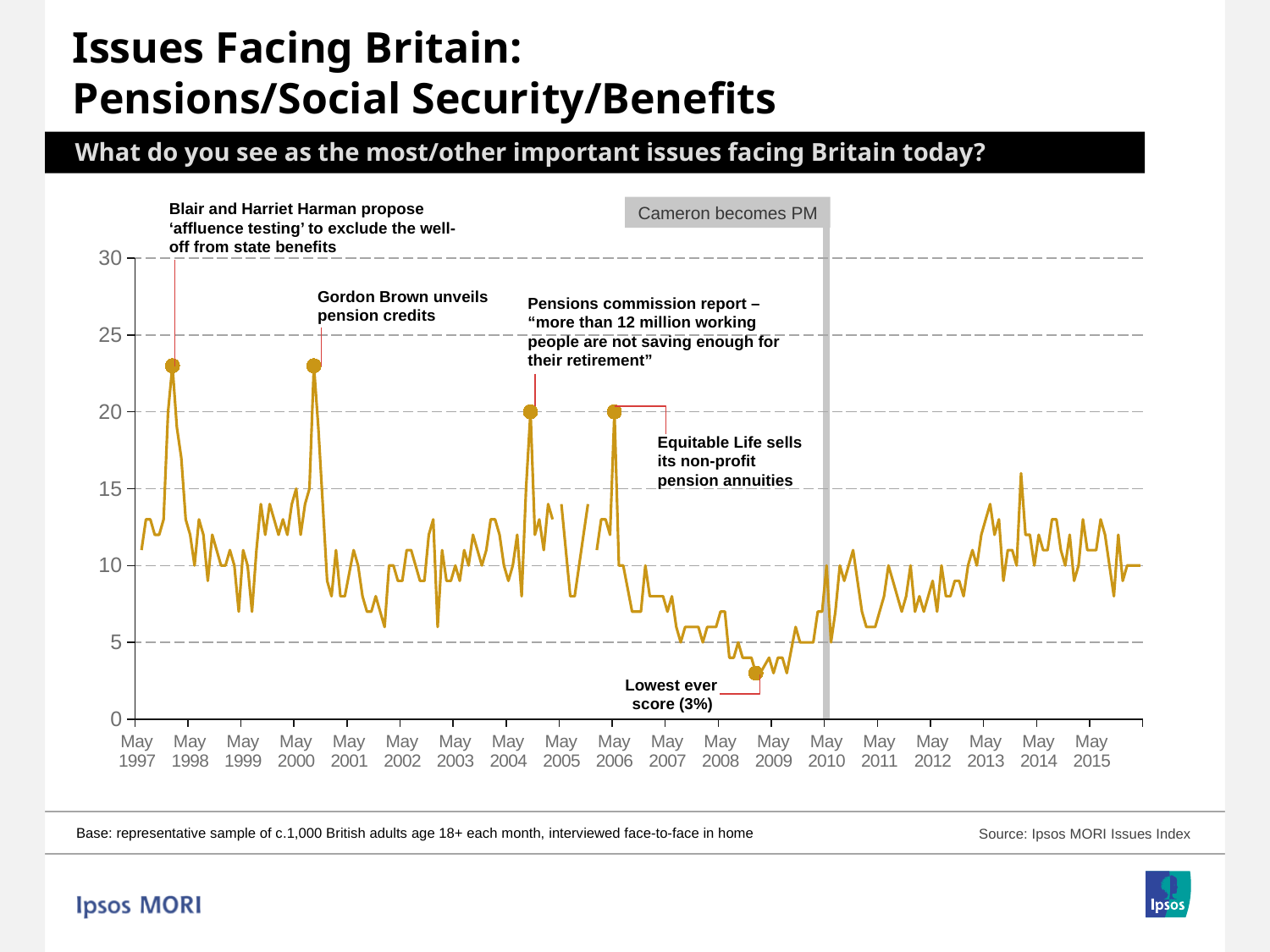
How many year labels are shown along the x axis? 19 What is the lowest ever score shown on the chart? 3% What event is marked by the grey vertical bar around 2010? Cameron becomes PM What kind of chart is shown on the slide? line chart Is the value at the point marked 'Lowest ever score' greater or less than 5? less Is the value at the peak marked 'Pensions commission report' greater or less than 15? greater Is the value at the peak marked 'Equitable Life sells its non-profit pension annuities' greater or less than 15? greater Between the lowest ever score in 2009 and May 2013, do the values generally rise or fall? rise Between the 2006 peak and the lowest ever score in 2009, do the values generally rise or fall? fall What is the highest value shown on the y axis? 30